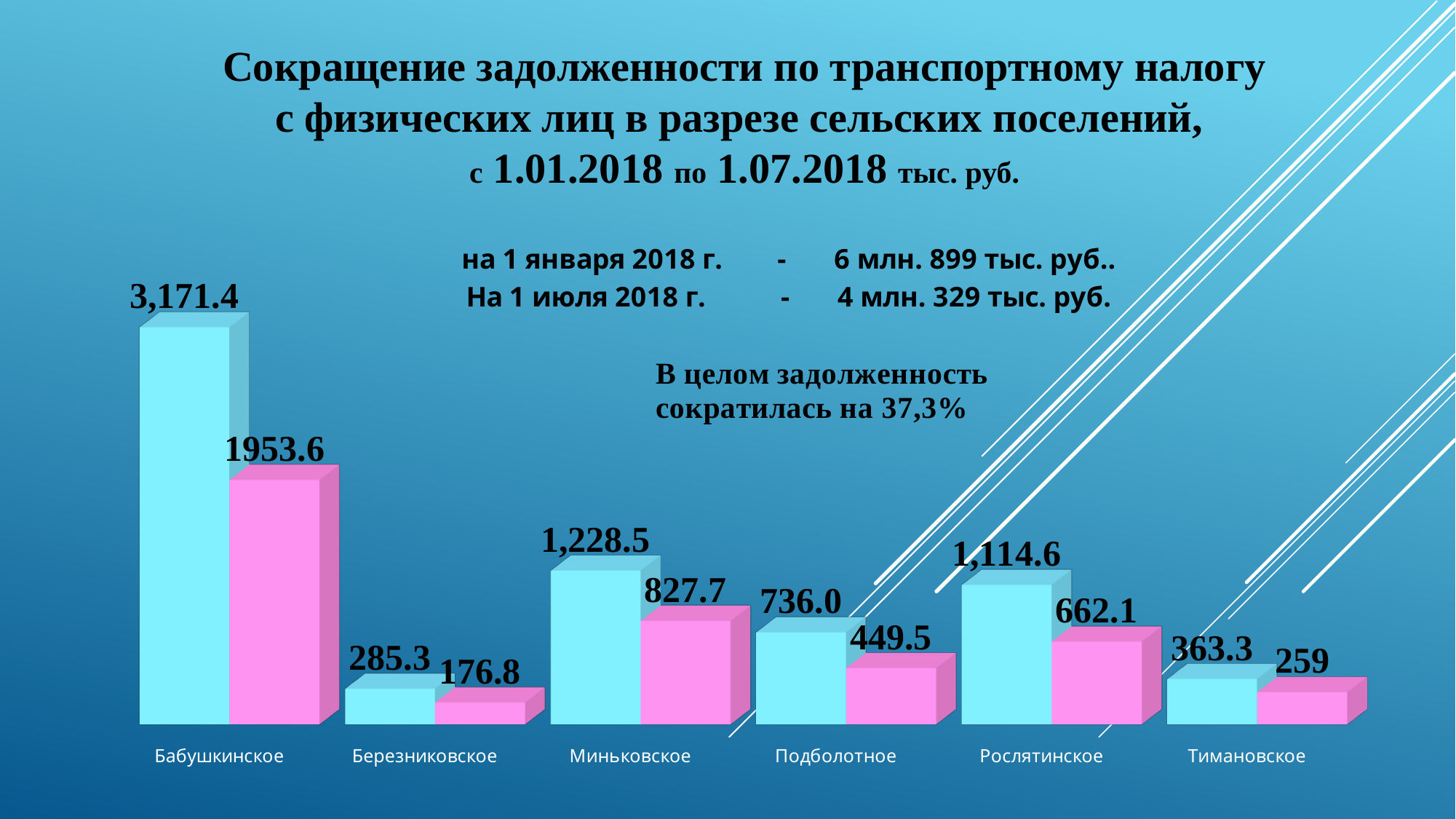
What is the difference between the light blue and pink bars for Подболотное? 286.5 How many settlements (categories) are shown on the x axis of the chart? 6 What type of chart is shown on the slide? bar chart What is the difference between the light blue and pink bars for Бабушкинское? 1217.8 What is the value of the pink bar for Тимановское? 259 Which settlement has the highest light blue bar? Бабушкинское Which settlement has the lowest pink bar? Березниковское What is the value of the light blue bar for Бабушкинское? 3,171.4 What is the value of the light blue bar for Рослятинское? 1,114.6 What is the value of the pink bar for Миньковское? 827.7 According to the text on the slide, by what percentage did the overall debt decrease? 37,3% Which is larger: the pink bar for Миньковское or the light blue bar for Подболотное? the pink bar for Миньковское